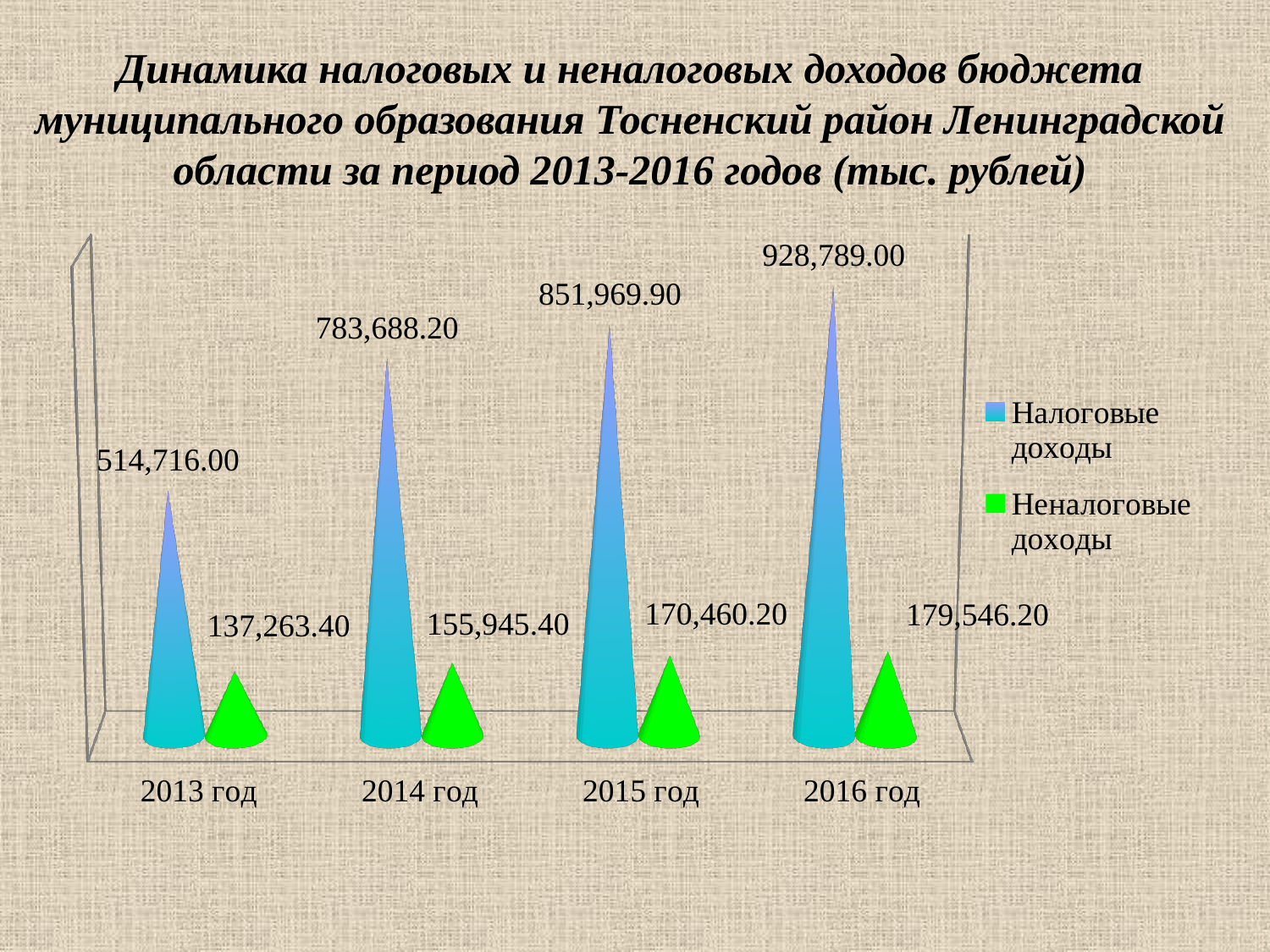
How many series does the legend list? 2 How many years are shown on the x axis? 4 What is the value of Налоговые доходы for 2016 год? 928,789.00 Which is larger in 2014 год: Налоговые доходы or Неналоговые доходы? Налоговые доходы In which year are Неналоговые доходы the lowest? 2013 год By how much did Налоговые доходы increase from 2015 год to 2016 год? 76,819.10 What is the value of Налоговые доходы for 2013 год? 514,716.00 In which year are Налоговые доходы the highest? 2016 год What is the value of Неналоговые доходы for 2015 год? 170,460.20 What is the value of Неналоговые доходы for 2014 год? 155,945.40 Do Налоговые доходы rise or fall from 2013 год to 2016 год? rise What is the difference between Неналоговые доходы in 2016 год and 2013 год? 42,282.80